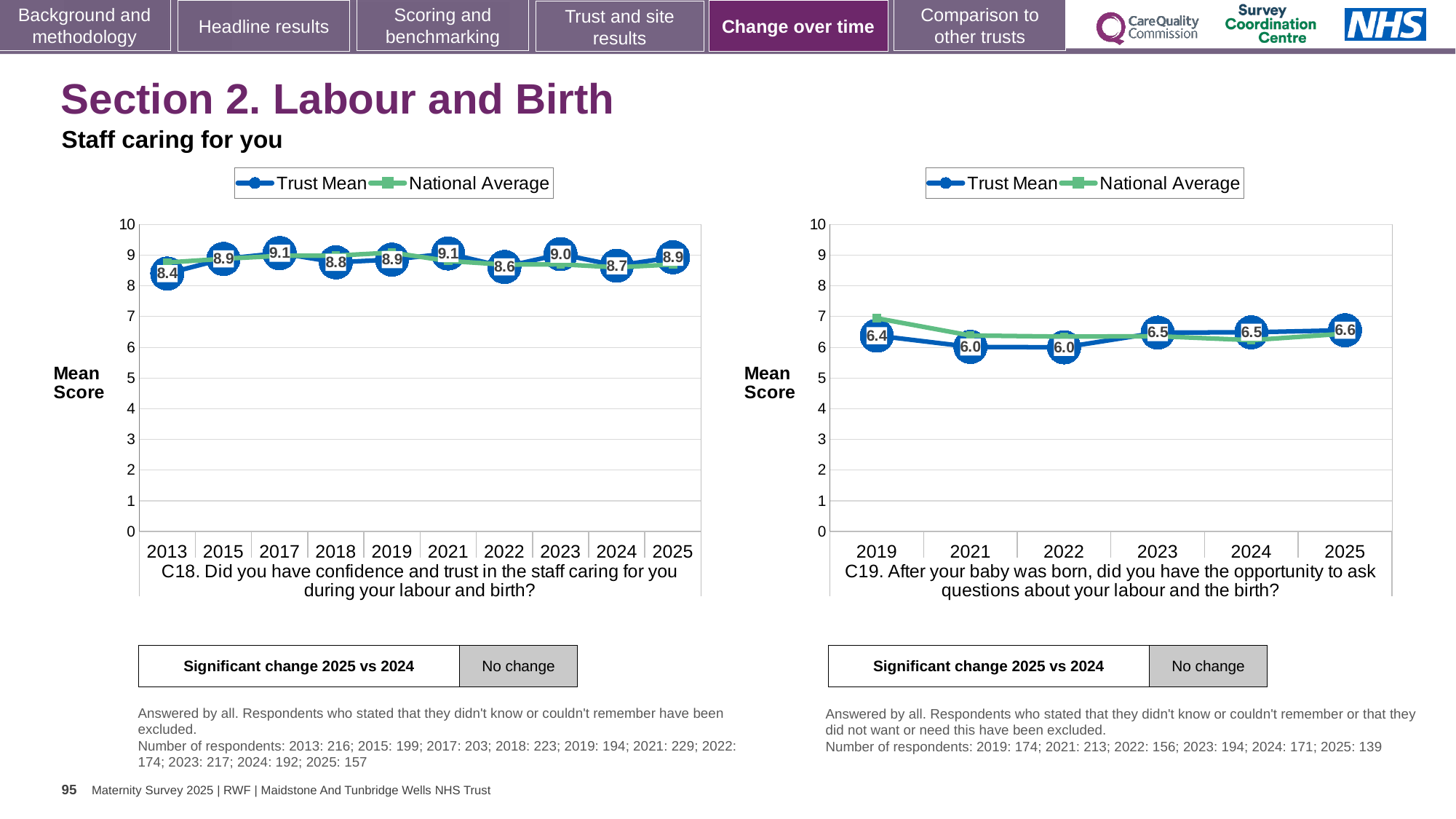
In the C19 chart on the right, which year has the highest Trust Mean score? 2025 In the C19 chart on the right, what is the Trust Mean score for 2025? 6.6 How many years are plotted on the x axis of the C19 chart on the right? 6 In the C18 chart on the left, what is the Trust Mean score for 2025? 8.9 In the C19 chart on the right, what is the Trust Mean score for 2022? 6.0 In the C18 chart on the left, what is the difference between the Trust Mean scores for 2017 and 2013? 0.7 How many series does the legend of the C18 chart on the left list? 2 In the C18 chart on the left, is the National Average value for 2013 greater or less than 8? greater In the C18 chart on the left, what is the Trust Mean score for 2013? 8.4 In the C18 chart on the left, which year has the lowest Trust Mean score? 2013 What kind of chart is the C19 chart on the right? Line chart In the C19 chart on the right, is the Trust Mean score higher in 2019 or in 2021? 2019